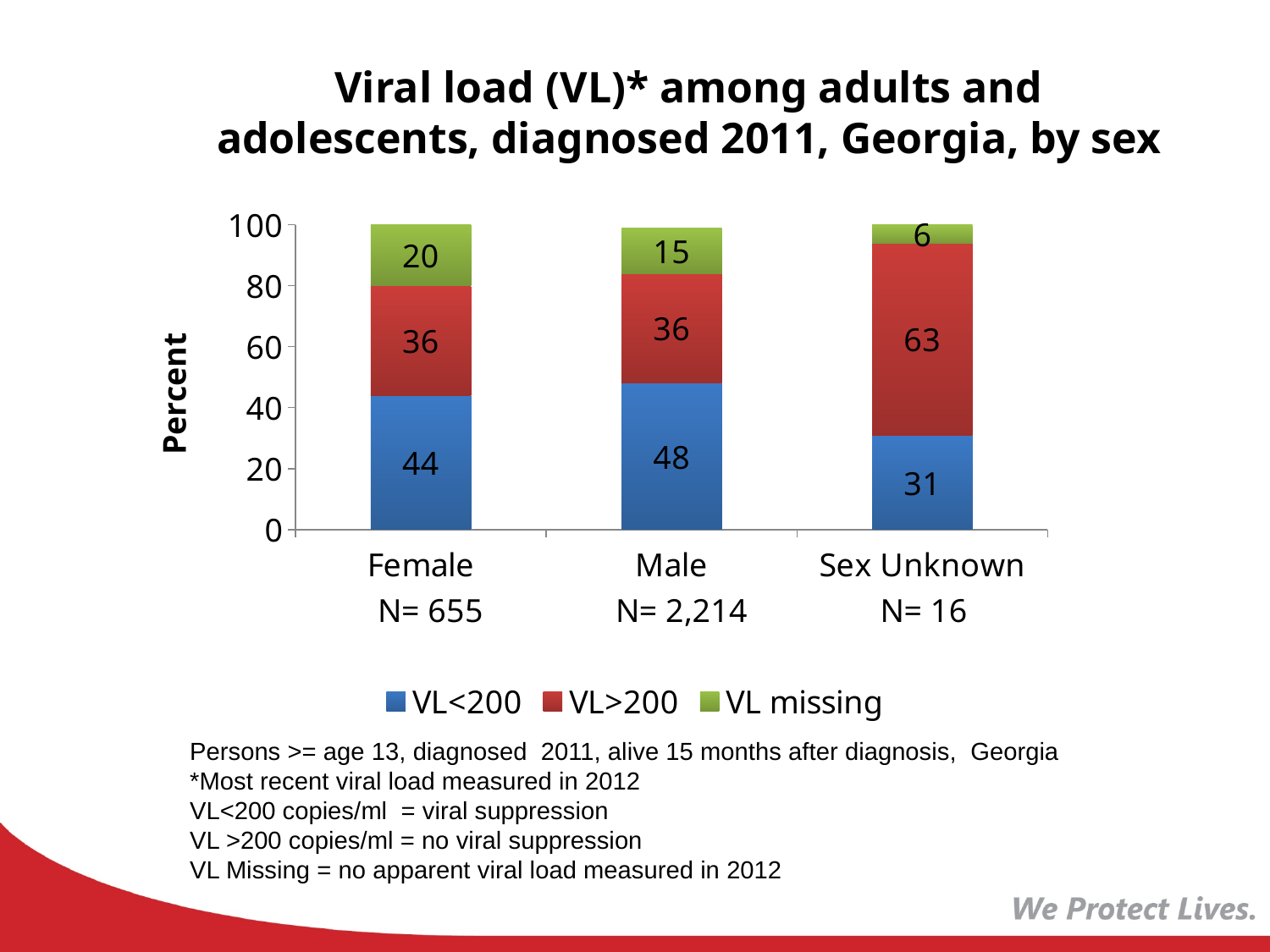
What is the label of the y axis? Percent What is the VL>200 value for Sex Unknown? 63 Which category has the highest VL<200 value? Male What is the total of the stacked bar for Male? 99 What is the VL missing value for Female? 20 What kind of chart is shown on the slide? Stacked bar chart How many series does the legend list? 3 What is the VL<200 value for Male? 48 What is the difference between the VL>200 values for Sex Unknown and Female? 27 How many categories are shown on the x axis? 3 Is the VL<200 value larger for Female or for Sex Unknown? Female Which category has the lowest VL missing value? Sex Unknown